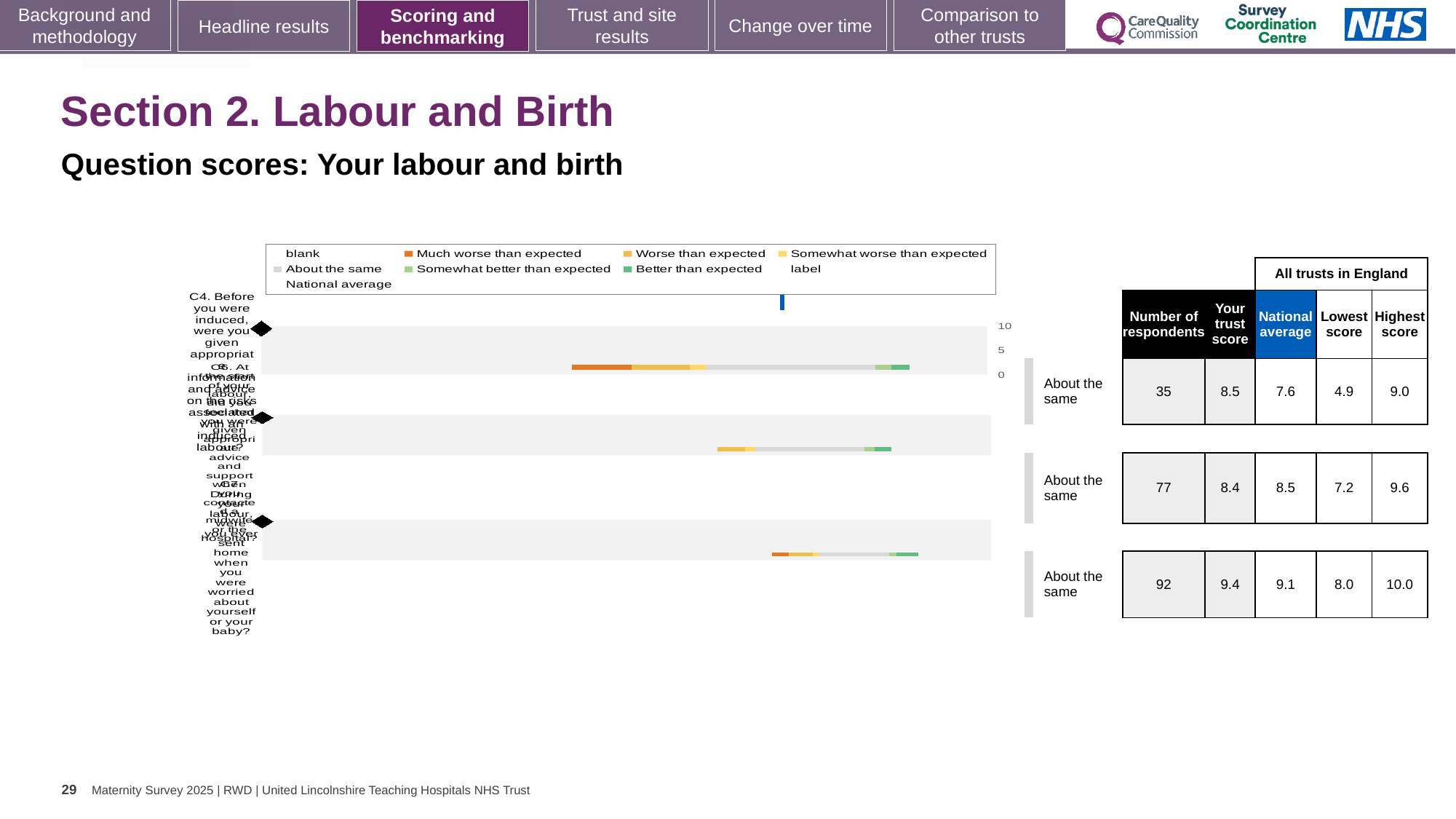
In the table beside the chart, what is the trust score for the third row? 9.4 What colour represents 'Better than expected' in the chart legend? green In the table beside the chart, for the first row, which is larger: the trust score or the national average? the trust score (8.5) In the table beside the chart, what is the number of respondents for the first row? 35 What kind of chart is shown on the slide? bar chart In the table beside the chart, for the second row, which is larger: the trust score or the national average? the national average (8.5) How many question rows are plotted in the chart? 3 In the table beside the chart, which row has the highest number of respondents? the third row (92) In the table beside the chart, what is the difference between the highest score and the lowest score for the first row? 4.1 What benchmark label is shown next to each of the three chart rows? About the same How many entries does the chart legend list? 9 What colour represents 'Much worse than expected' in the chart legend? orange